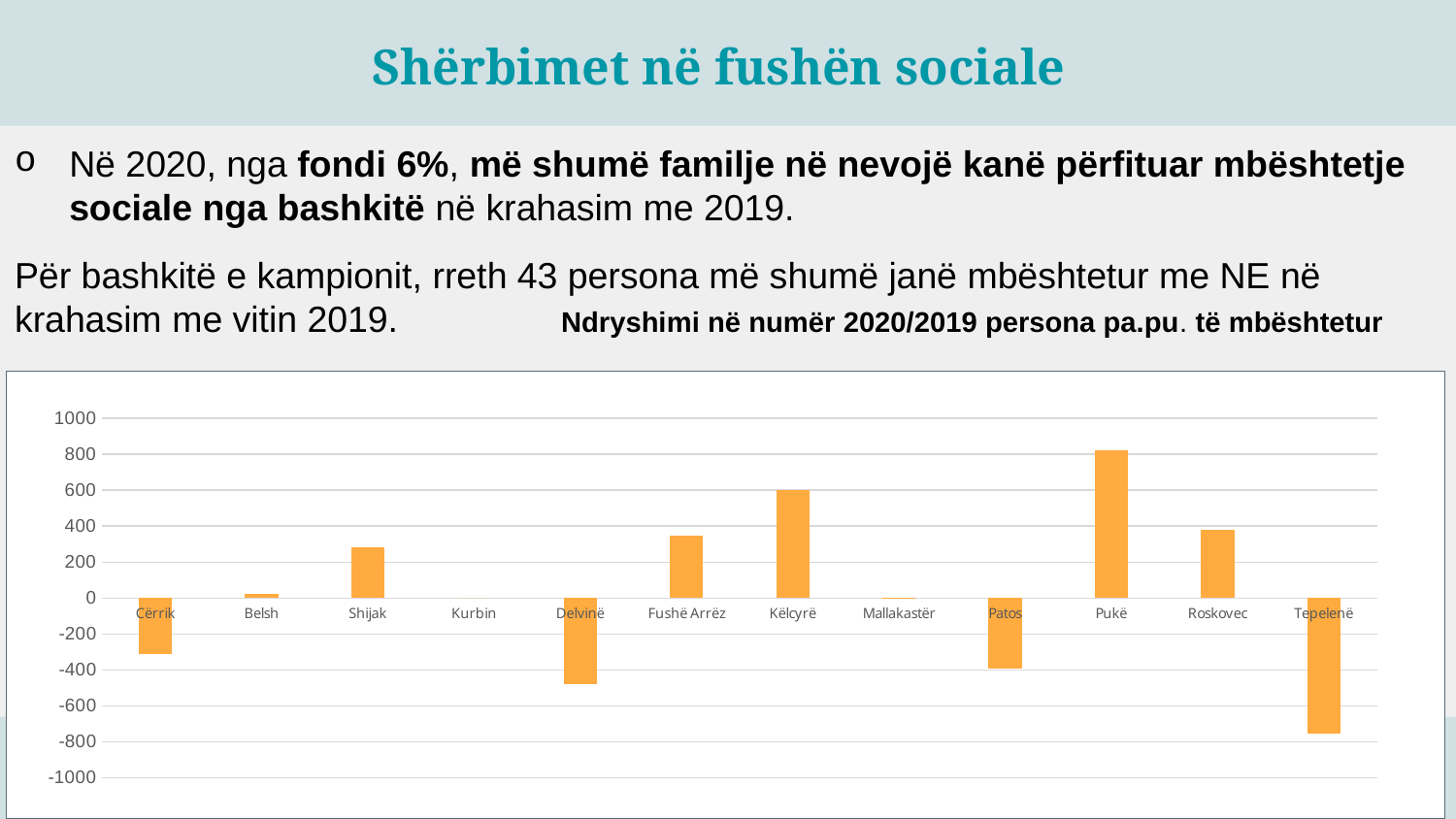
Is the value for Shijak greater or less than 200? greater Is the value for Cërrik greater or less than -200? less Which has the larger value, Këlcyrë or Fushë Arrëz? Këlcyrë Which has the larger value, Roskovec or Belsh? Roskovec Which municipality has the lowest value in the chart? Tepelenë Is the value for Tepelenë greater or less than -600? less What is the title of the chart? Ndryshimi në numër 2020/2019 persona pa.pu. të mbështetur Which municipality has the highest value in the chart? Pukë How many municipalities (categories) are shown on the x axis of the chart? 12 What kind of chart is shown on the slide? bar chart